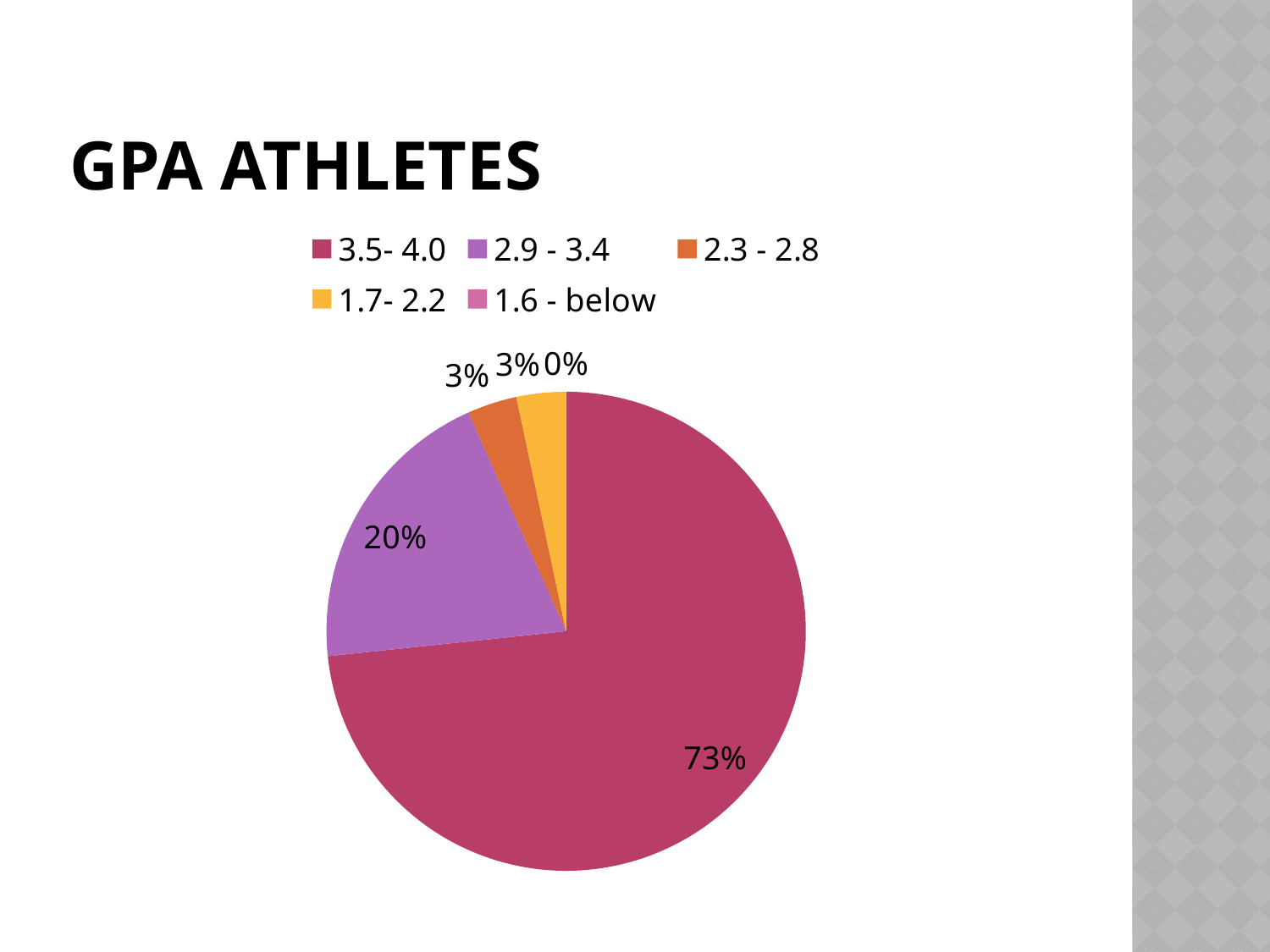
How many GPA ranges does the legend list? 5 What share of the pie does the 1.6 - below GPA range have? 0% What is the title of the slide containing the pie chart? GPA ATHLETES What colour is the slice for the 2.9 - 3.4 GPA range? purple Which slice is larger, 2.9 - 3.4 or 1.7- 2.2? 2.9 - 3.4 What kind of chart is shown on the slide? pie chart What is the difference in percentage points between the 3.5- 4.0 slice and the 2.9 - 3.4 slice? 53 Which GPA range has the smallest slice of the pie? 1.6 - below Which GPA range has the largest slice of the pie? 3.5- 4.0 What share of the pie does the 2.9 - 3.4 GPA range have? 20% What share of the pie does the 2.3 - 2.8 GPA range have? 3%